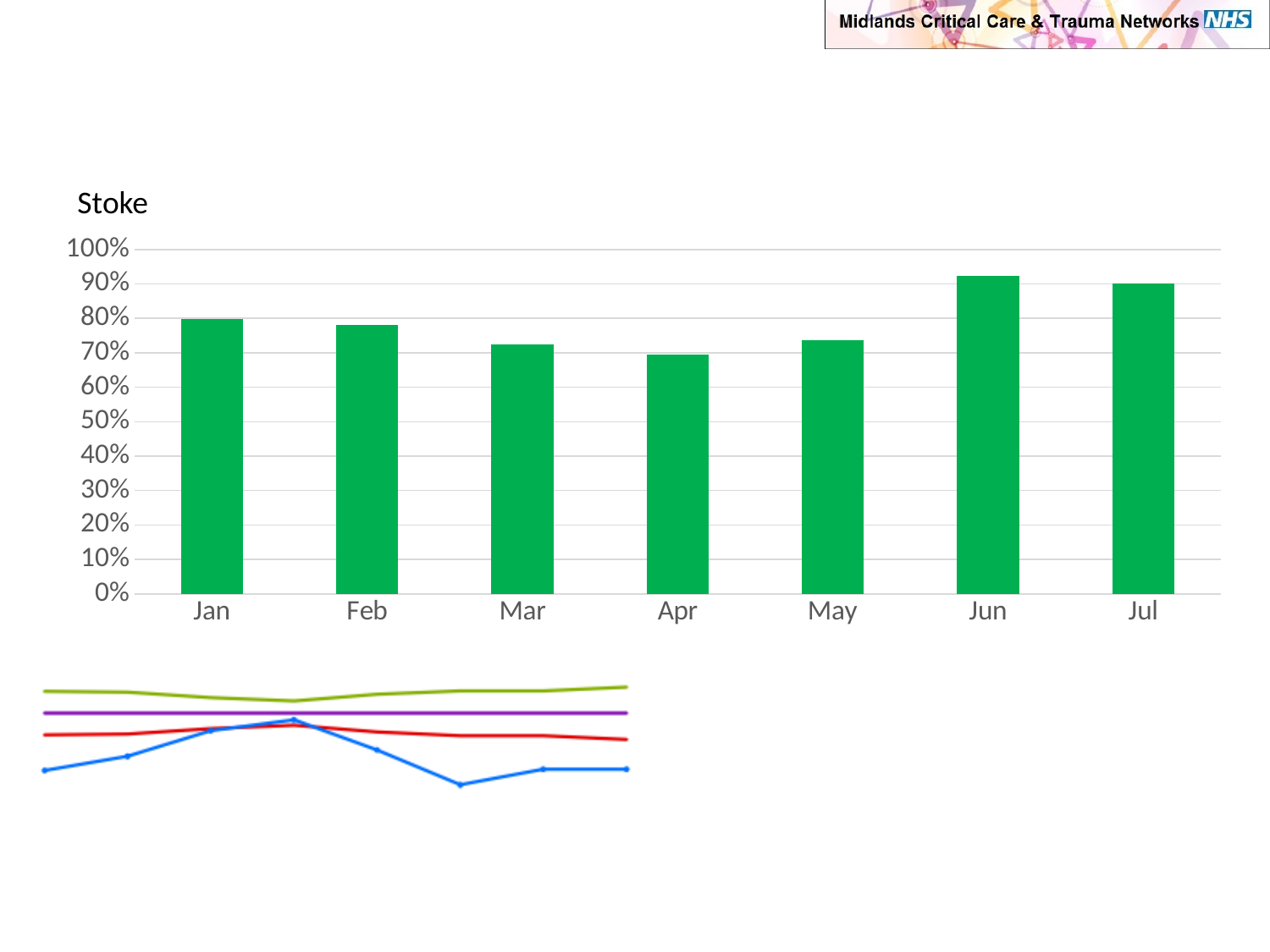
In the Stoke bar chart, is the value for Apr greater or less than 80%? less How many months are shown on the x axis of the Stoke bar chart? 7 In the Stoke bar chart, is the value for Jul greater or less than 80%? greater What is the title of the bar chart on the slide? Stoke In the Stoke bar chart, which is larger, the value for Jun or the value for Mar? Jun In the Stoke bar chart, is the value for Jan greater or less than 70%? greater What kind of chart is the Stoke chart? bar chart In the Stoke bar chart, do the values rise or fall from Apr to Jun? rise Which month has the highest bar in the Stoke bar chart? Jun In the Stoke bar chart, which is larger, the value for Jan or the value for Apr? Jan Which month has the lowest bar in the Stoke bar chart? Apr